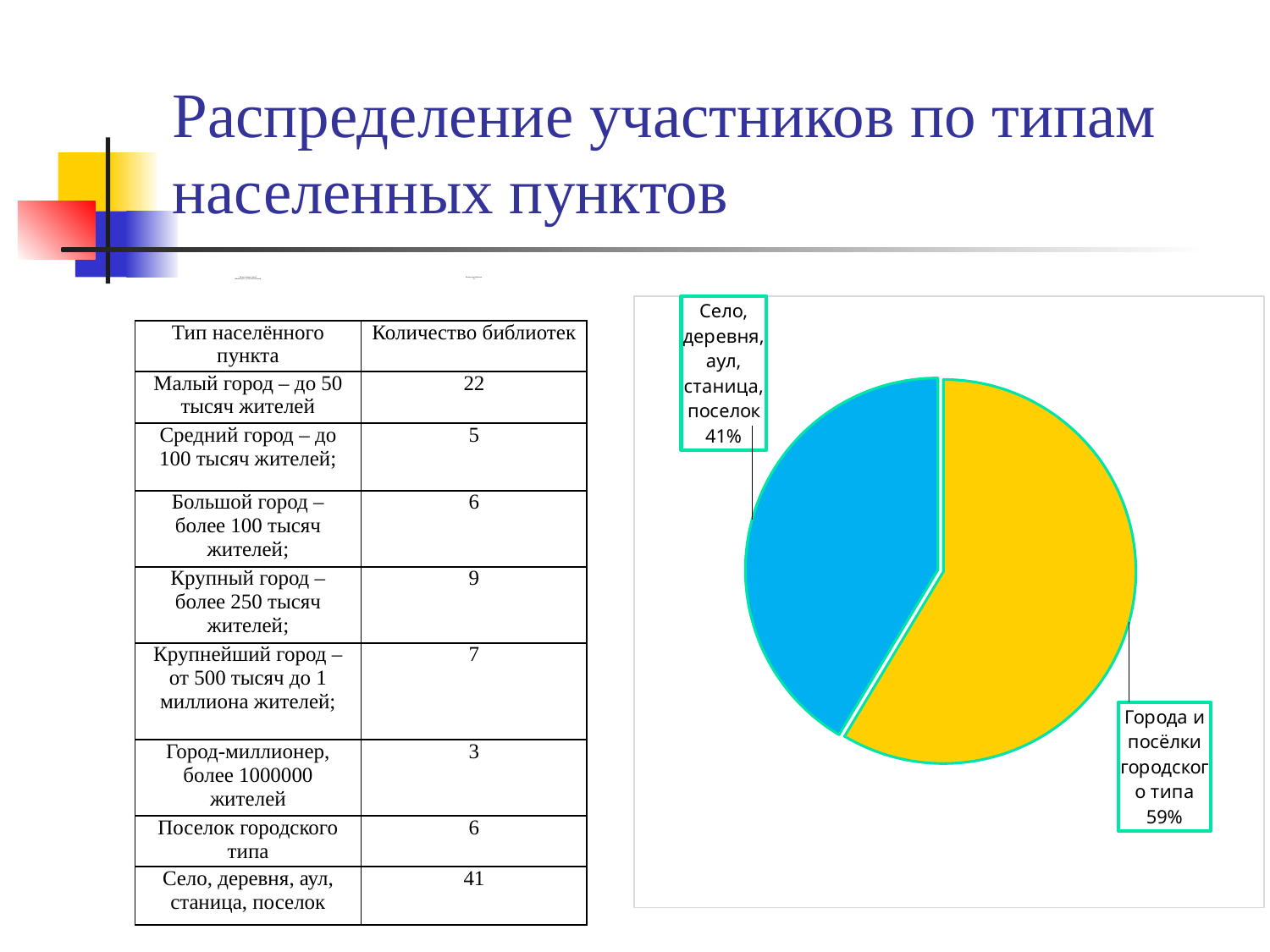
By how many percentage points does the 'Города и посёлки городского типа' slice exceed the 'Село, деревня, аул, станица, поселок' slice? 18 Is the share of 'Село, деревня, аул, станица, поселок' greater or less than 50%? less What share of the pie does the slice 'Село, деревня, аул, станица, поселок' represent? 41% How many slices does the pie chart have? 2 What share of the pie does the slice 'Города и посёлки городского типа' represent? 59% What kind of chart is shown on the slide? pie chart Which slice of the pie chart is the largest? Города и посёлки городского типа What colour is the 'Село, деревня, аул, станица, поселок' slice in the pie chart? blue Which slice of the pie chart is the smallest? Село, деревня, аул, станица, поселок Which is larger in the pie chart: 'Города и посёлки городского типа' or 'Село, деревня, аул, станица, поселок'? Города и посёлки городского типа What colour is the 'Города и посёлки городского типа' slice in the pie chart? yellow